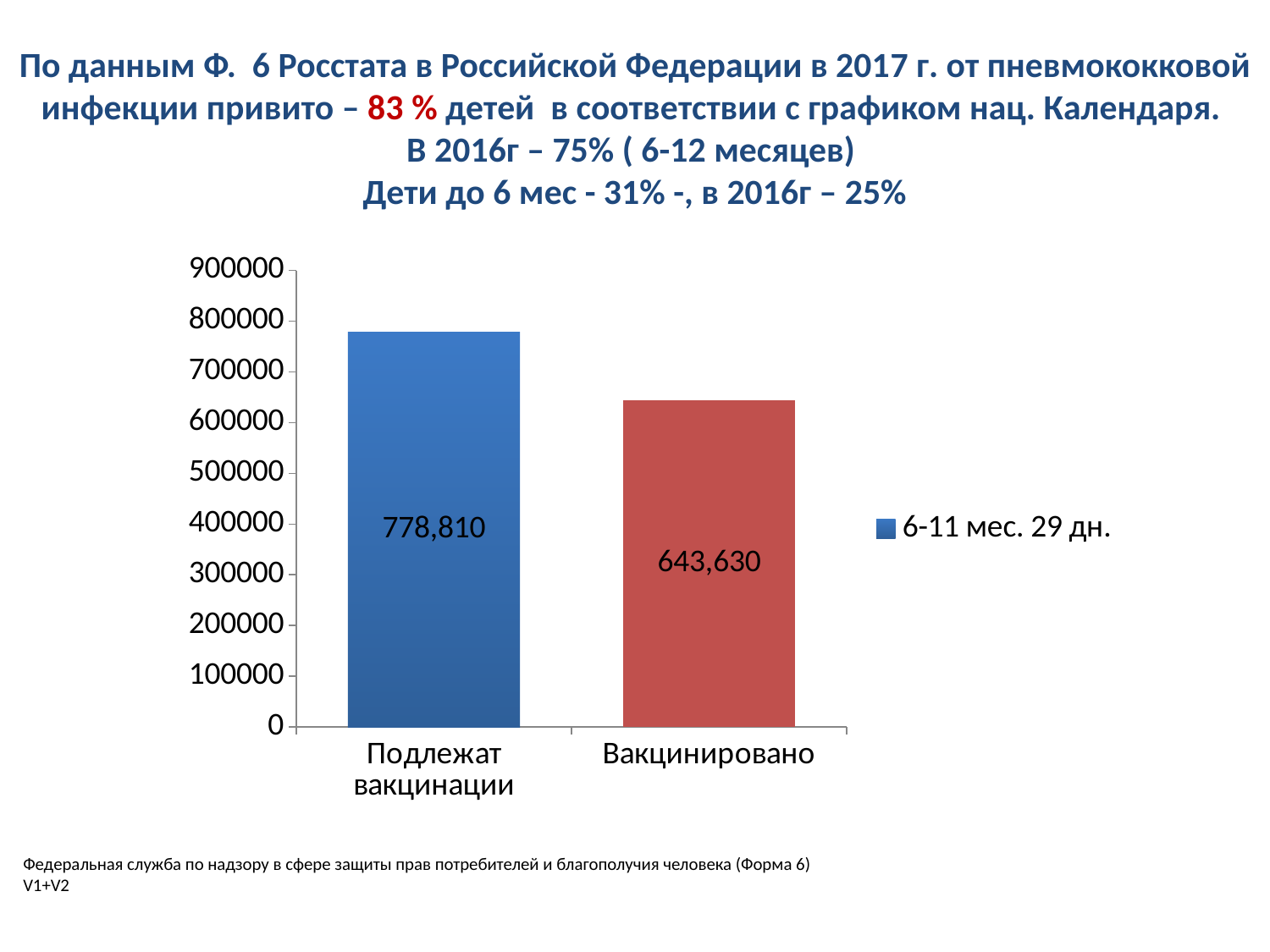
How many categories are shown on the x axis of the chart? 2 What kind of chart is shown on the slide? bar chart Which is larger, the value for "Подлежат вакцинации" or the value for "Вакцинировано"? Подлежат вакцинации How many series does the legend list? 1 Which category has the highest value? Подлежат вакцинации What is the difference between the values for "Подлежат вакцинации" and "Вакцинировано"? 135,180 What is the legend entry of the chart? 6-11 мес. 29 дн. What is the value for "Вакцинировано"? 643,630 Which category has the lowest value? Вакцинировано What is the value for "Подлежат вакцинации"? 778,810 Is the value for "Вакцинировано" greater or less than 700000? less Is the value for "Подлежат вакцинации" greater or less than 700000? greater